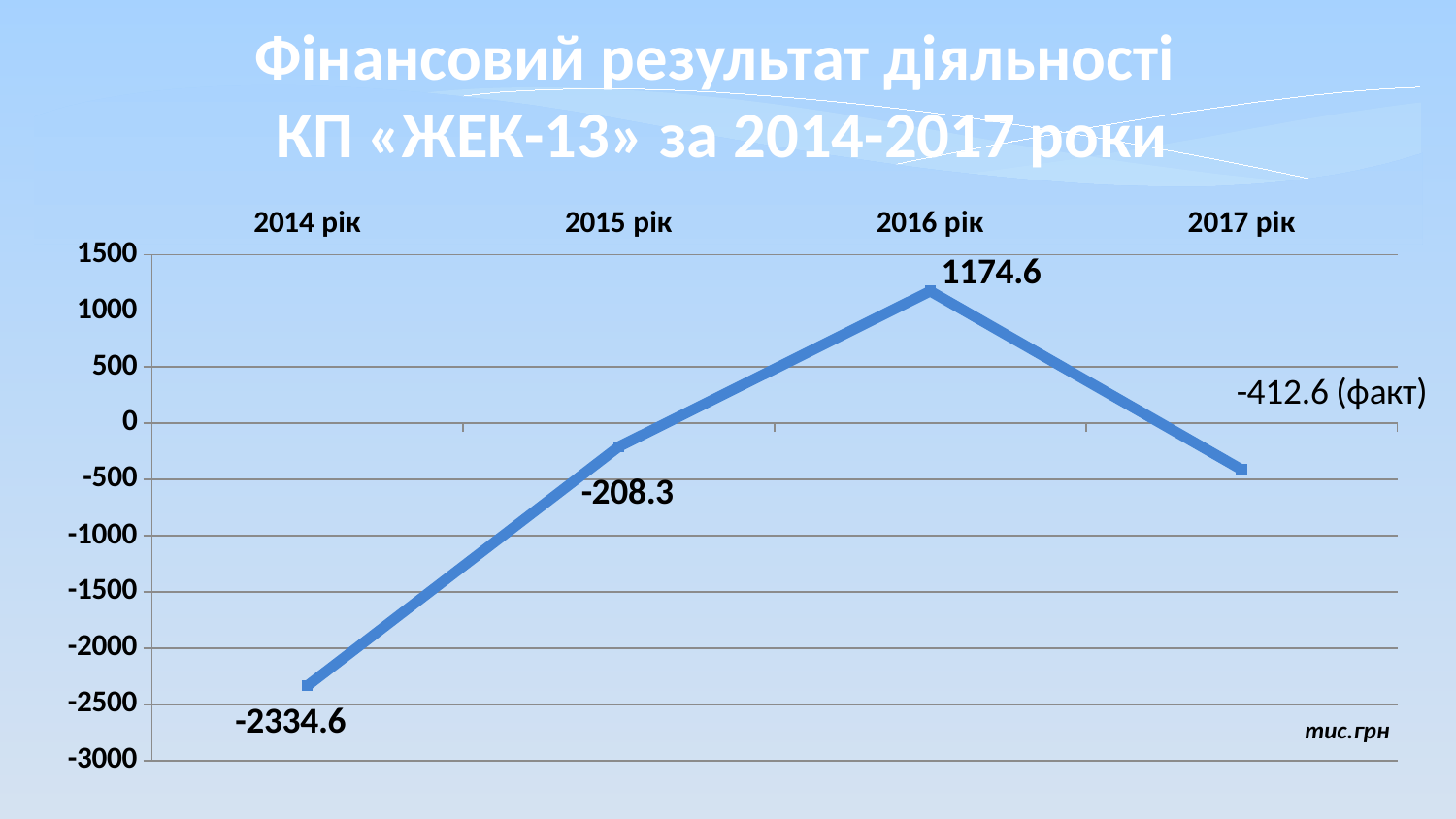
What is the value for 2014 рік? -2334.6 Which year has the highest value? 2016 рік How many data points are plotted on the chart? 4 Which is larger, the value for 2015 рік or the value for 2017 рік? 2015 рік What is the value for 2015 рік? -208.3 What is the value for 2017 рік? -412.6 What is the value for 2016 рік? 1174.6 What kind of chart is shown on the slide? Line chart What is the difference between the values for 2016 рік and 2015 рік? 1382.9 Do the values rise or fall from 2014 рік to 2016 рік? Rise Which year has the lowest value? 2014 рік What is the difference between the values for 2015 рік and 2014 рік? 2126.3